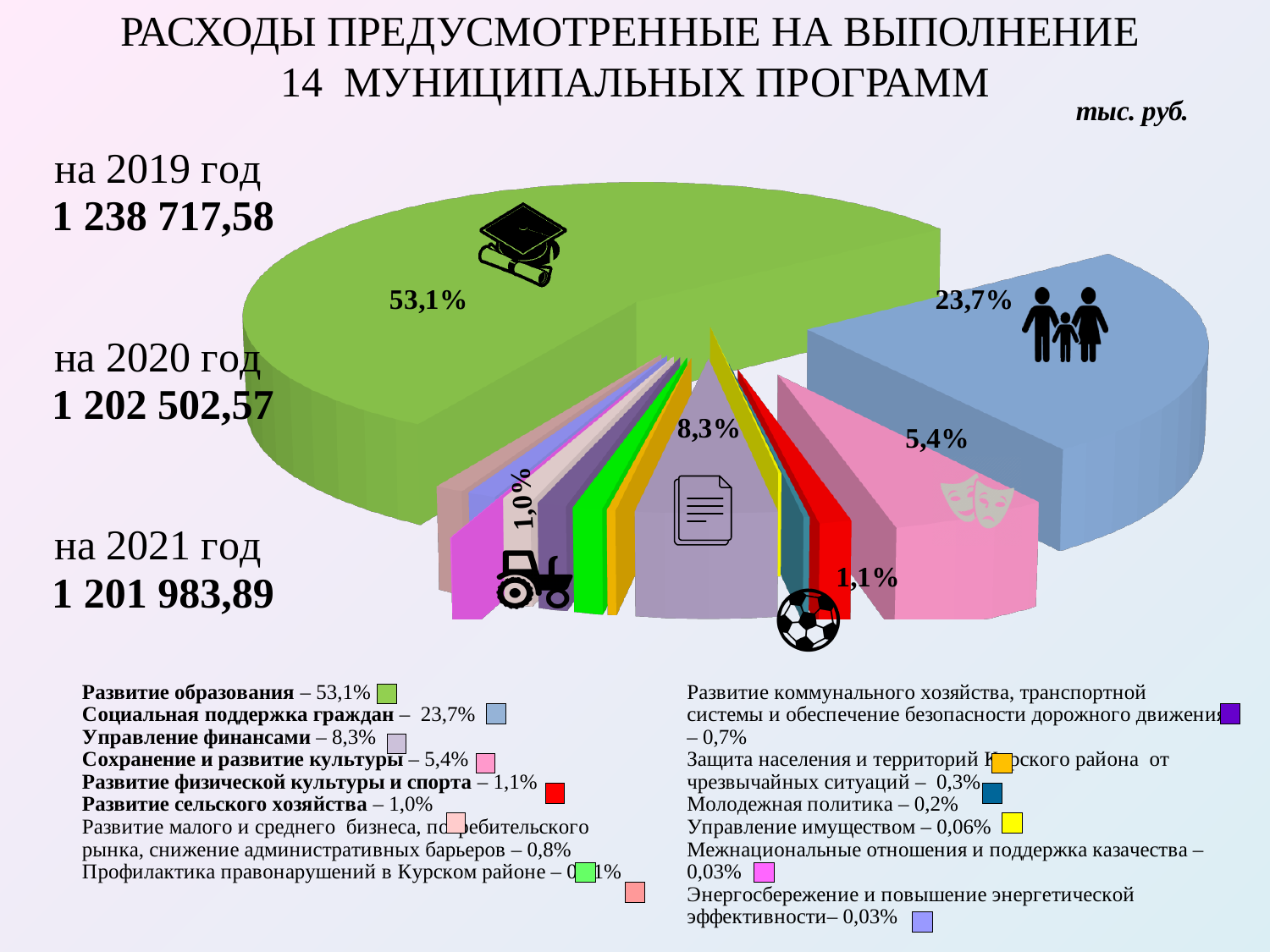
What share does Сохранение и развитие культуры have? 5,4% What percentage is given for Развитие сельского хозяйства? 1,0% What share is listed for Управление имуществом? 0,06% What kind of chart is shown on the slide? pie chart What unit of measurement is indicated on the slide for the expenditures? тыс. руб. Which has the larger share: Развитие физической культуры и спорта or Развитие сельского хозяйства? Развитие физической культуры и спорта How many municipal programs does the chart cover, according to the title? 14 What share of the chart does Развитие образования account for? 53,1% Which program has the largest share of the pie? Развитие образования What is the difference in percentage points between Развитие образования and Социальная поддержка граждан? 29,4 What share is shown for Социальная поддержка граждан? 23,7% What percentage is shown for Управление финансами? 8,3%